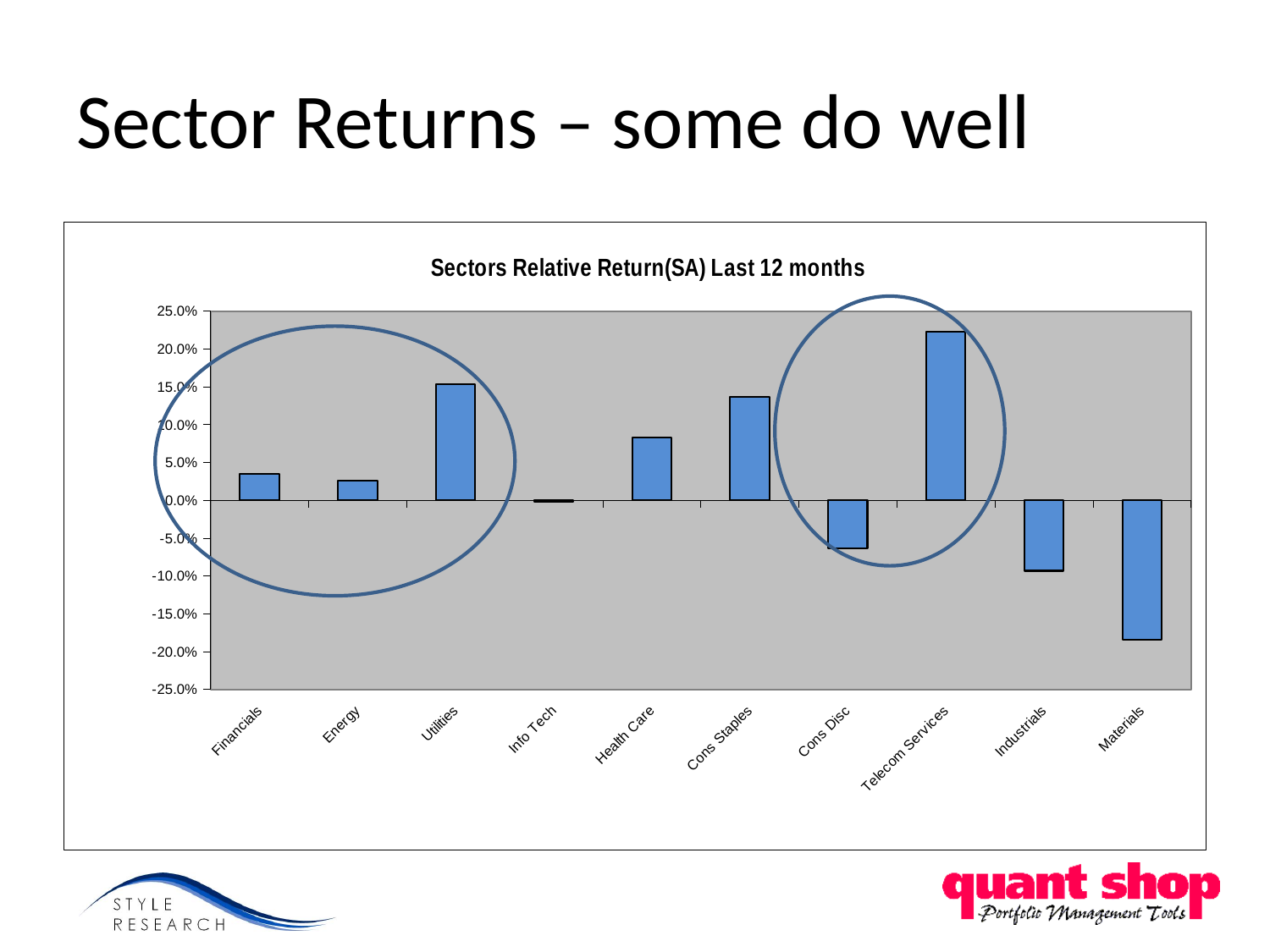
Is the value for Materials greater or less than -15.0%? less How many sectors are plotted on the x axis? 10 Is the value for Industrials greater or less than -5.0%? less Is the value for Telecom Services greater or less than 20.0%? greater What kind of chart is shown on the slide? bar chart Which has the larger relative return, Telecom Services or Utilities? Telecom Services Which sector has the highest relative return? Telecom Services Which has the larger relative return, Health Care or Financials? Health Care Which sector has the lowest relative return? Materials What is the title of the chart? Sectors Relative Return(SA) Last 12 months